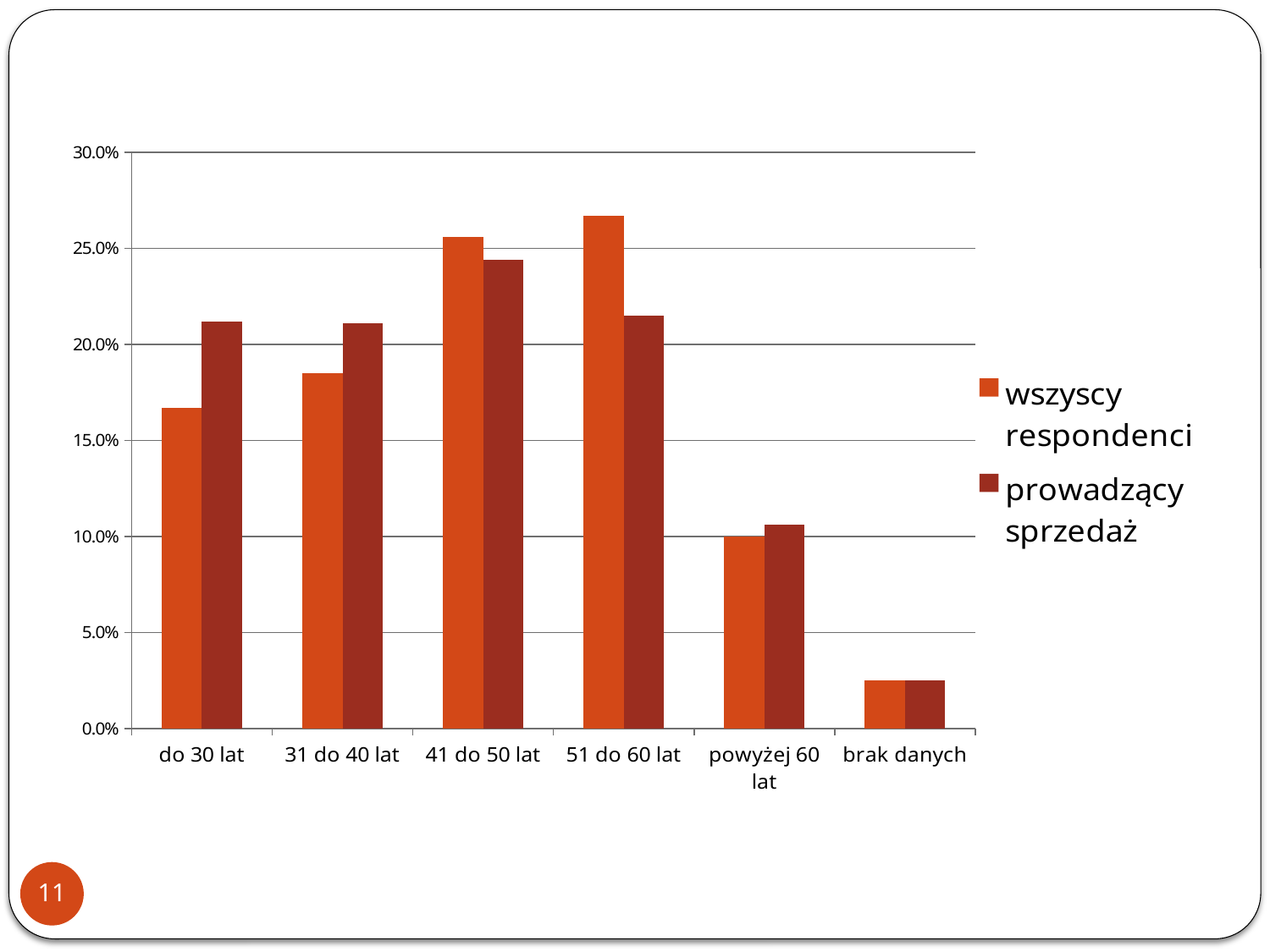
What kind of chart is shown on the slide? bar chart How many age categories are shown on the x axis? 6 For the category '51 do 60 lat', which series has the larger value? wszyscy respondenci How many series does the legend list? 2 For the category 'do 30 lat', which series has the larger value? prowadzący sprzedaż Which category has the highest value for the 'prowadzący sprzedaż' series? 41 do 50 lat What are the two series names listed in the legend? wszyscy respondenci, prowadzący sprzedaż Is the value for 'wszyscy respondenci' in the '31 do 40 lat' category greater or less than 20.0%? less Is the value for 'prowadzący sprzedaż' in the '51 do 60 lat' category greater or less than 25.0%? less Is the value for 'wszyscy respondenci' in the '51 do 60 lat' category greater or less than 25.0%? greater Which category has the lowest value for the 'wszyscy respondenci' series? brak danych Which category has the highest value for the 'wszyscy respondenci' series? 51 do 60 lat